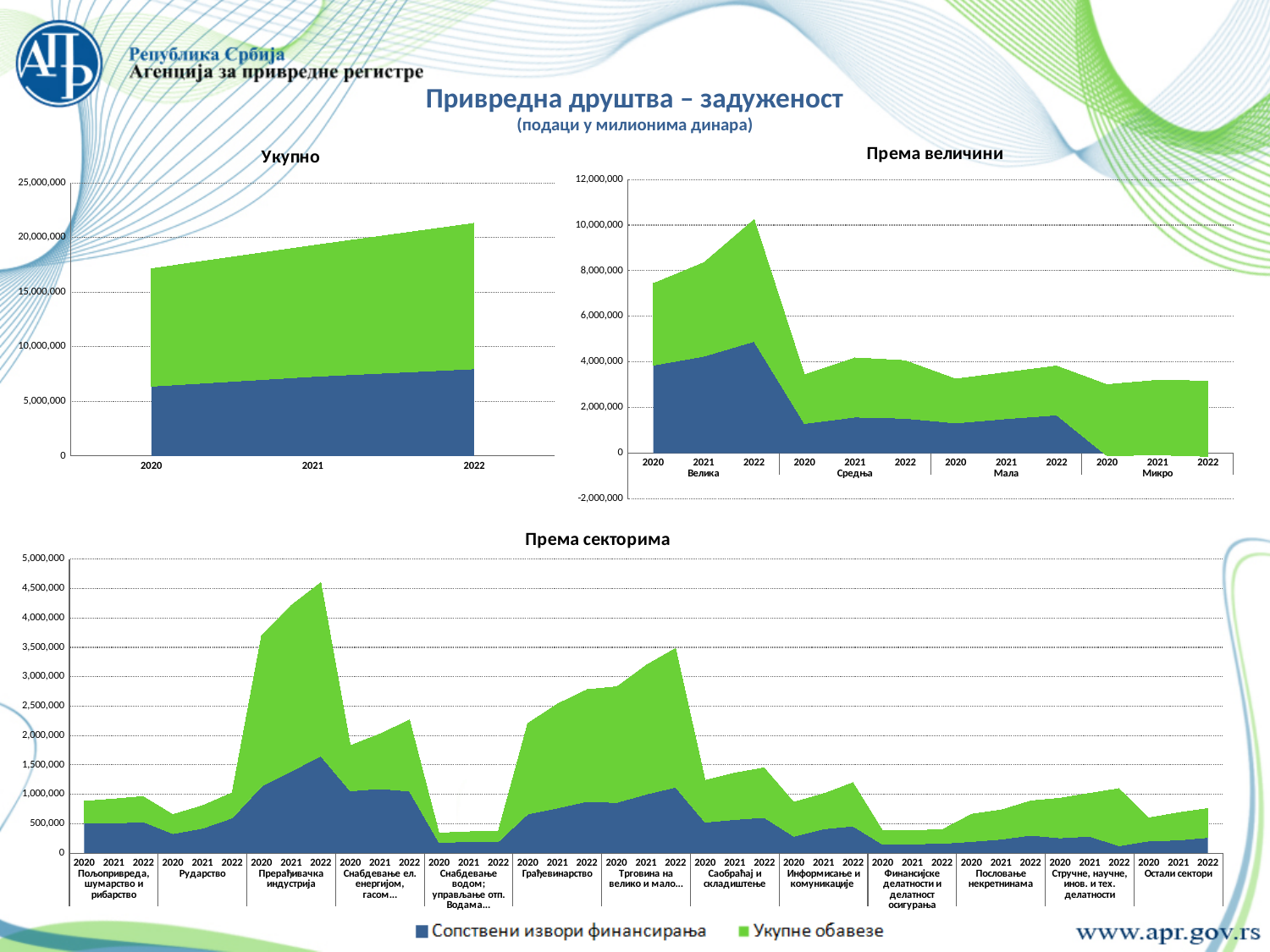
What are the two legend entries shown at the bottom of the slide? Сопствени извори финансирања; Укупне обавезе In the "Према величини" chart, is the total for Велика in 2022 greater or less than 8,000,000? greater What kind of chart is the "Укупно" chart? area chart How many series does the legend at the bottom of the slide list? 2 How many sectors are shown on the x axis of the "Према секторима" chart? 13 In the "Према секторима" chart, which sector reaches the highest total? Прерађивачка индустрија How many years are plotted on the x axis of the "Укупно" chart? 3 In the "Укупно" chart, does the total (top of the stacked area) rise or fall from 2020 to 2022? rise In the "Према секторима" chart, which has the larger total in 2022: Рударство or Прерађивачка индустрија? Прерађивачка индустрија How many size groups are shown on the x axis of the "Према величини" chart? 4 In the "Укупно" chart, is the total for 2022 greater or less than 20,000,000? greater In the "Према величини" chart, which size group has the highest total? Велика